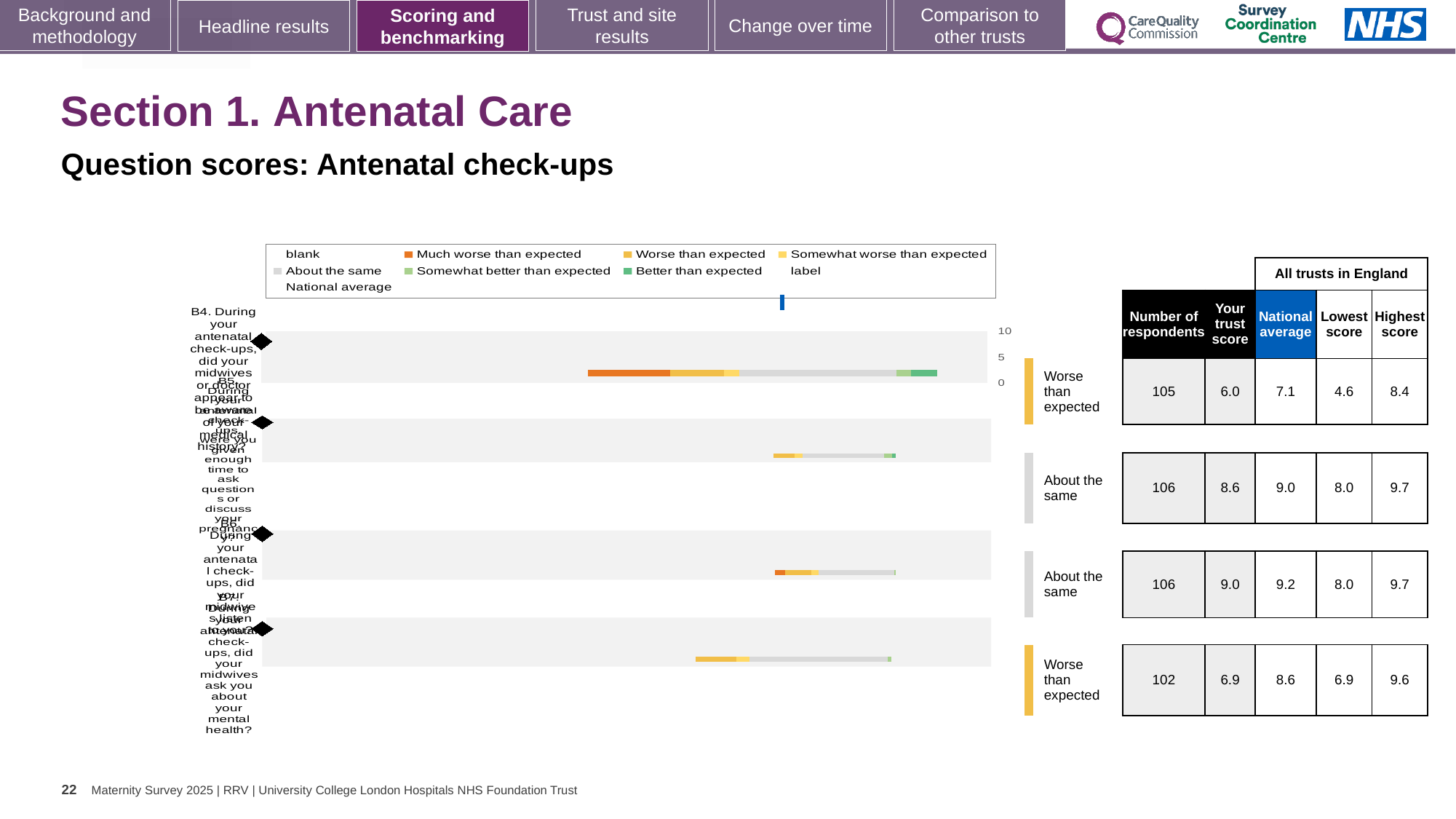
What is the trust score for question B4 (awareness of medical history)? 6.0 What is the lowest score across all trusts in England for the second question row (B5)? 8.0 Which question row has the highest trust score? the third row (B6) Is the trust score for question B4 larger or smaller than the trust score for question B7? smaller What is the highest score across all trusts in England for question B7 (asked about mental health)? 9.6 How many questions (rows) are plotted in the chart? 4 Which question row has the lowest trust score? B4 (awareness of medical history) What benchmark category is shown for question B4 (awareness of medical history)? Worse than expected What is the number of respondents for the last question, B7 (asked about mental health)? 102 What is the national average for question B4 (awareness of medical history)? 7.1 What is the difference between the national average and the trust score for question B7 (asked about mental health)? 1.7 What kind of chart is used to show the question scores on this slide? bar chart